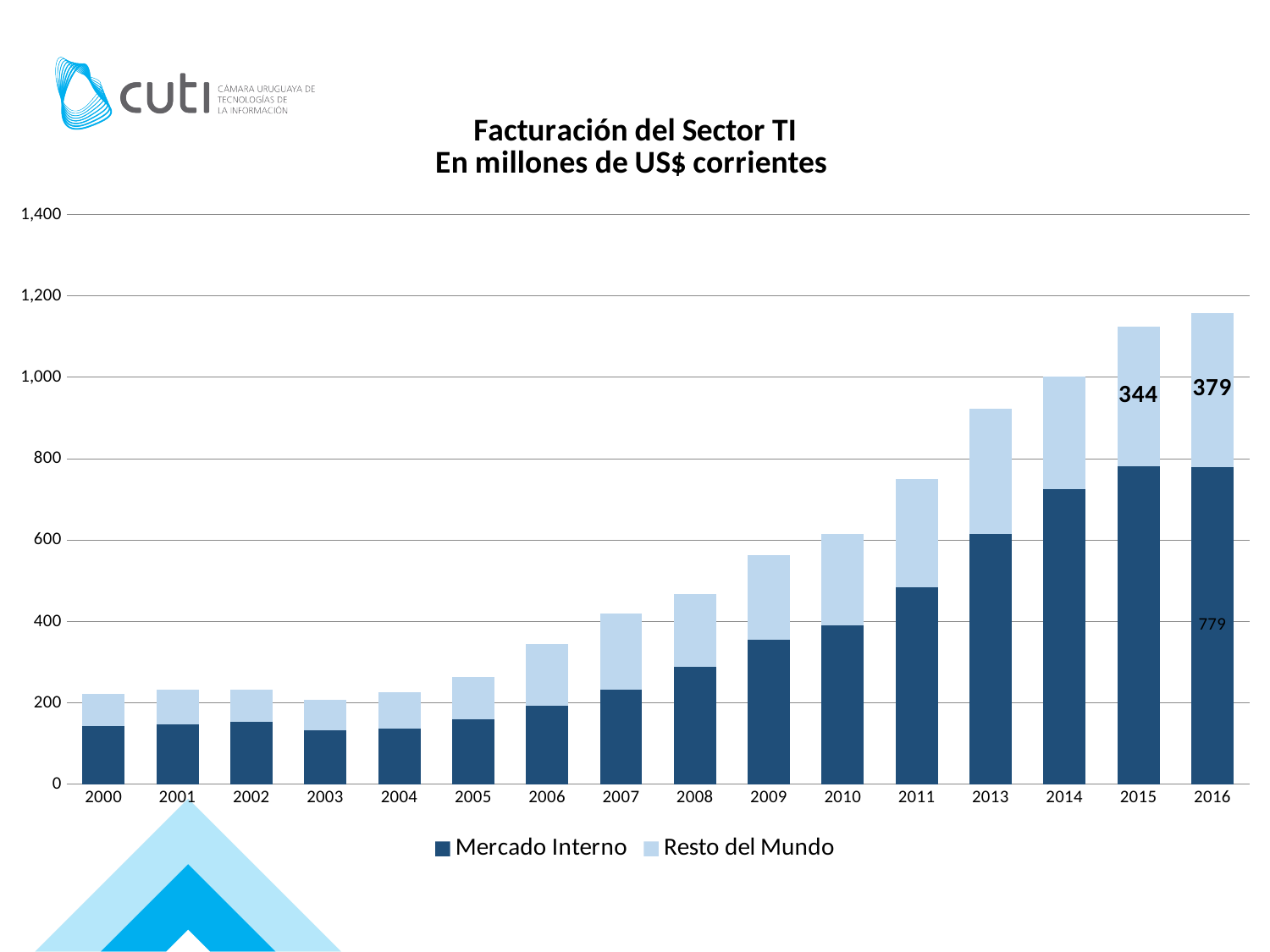
What is the total of the stacked bar for 2016? 1158 What type of chart is shown on the slide? stacked bar chart Which year has the highest total bar? 2016 Is the total value for 2013 greater or less than 800? greater What is the difference between the Resto del Mundo values for 2016 and 2015? 35 What is the Resto del Mundo value for 2015? 344 What is the Mercado Interno value for 2016? 779 How many series does the legend list? 2 What is the Resto del Mundo value for 2016? 379 Do the total values generally rise or fall from 2000 to 2016? rise How many years are shown on the x axis? 16 What is the title of the chart? Facturación del Sector TI En millones de US$ corrientes